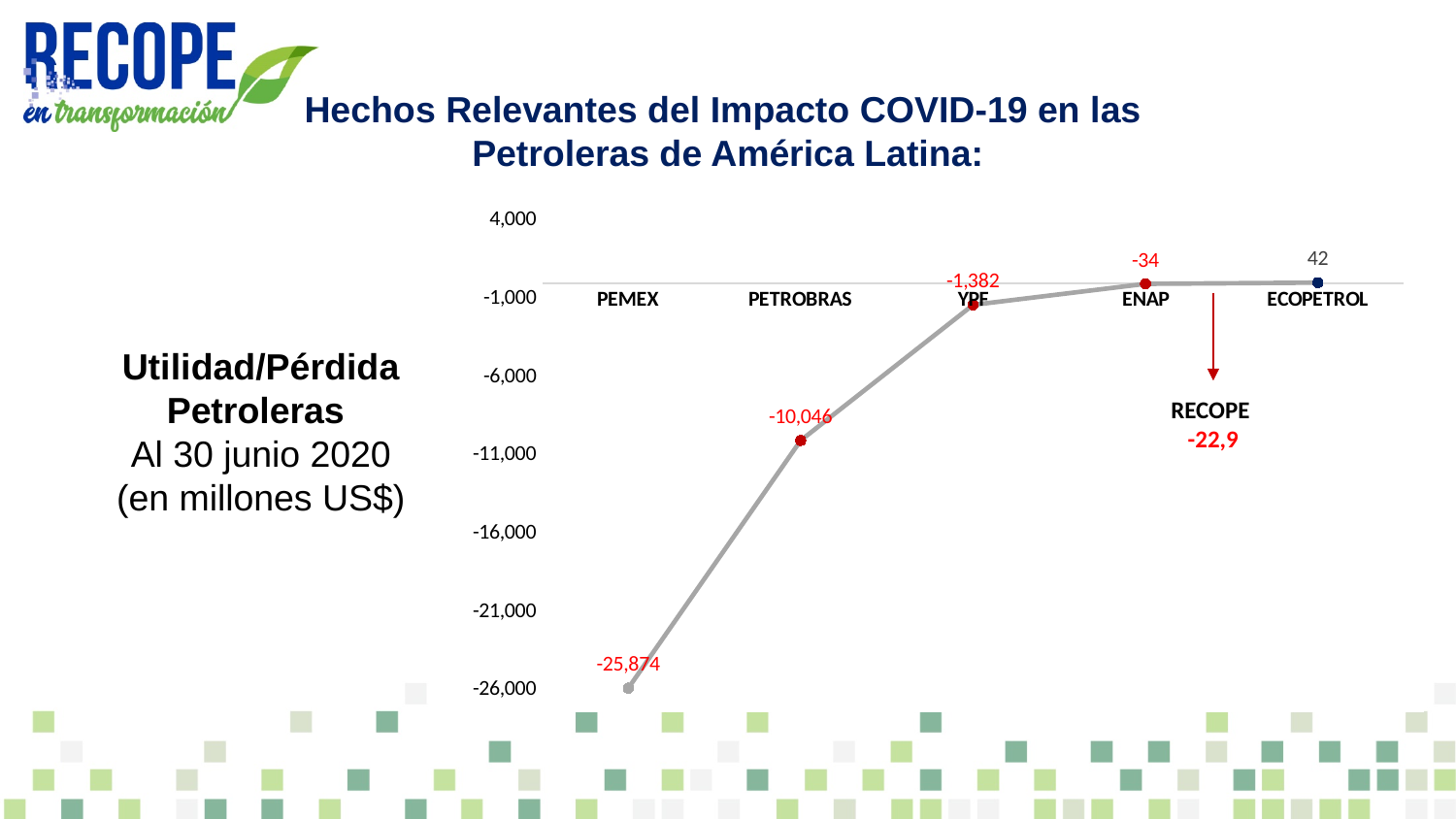
How many companies are plotted on the chart? 5 What is the value for PETROBRAS? -10,046 What kind of chart is shown on the slide? line chart Which company has the highest value? ECOPETROL What is the value for ECOPETROL? 42 What is the value for PEMEX? -25,874 What is the value for ENAP? -34 Which company has the lowest value? PEMEX What is the value for YPF? -1,382 Do the values rise or fall from PEMEX to ECOPETROL along the x axis? rise Which is larger, the value for YPF or the value for PETROBRAS? YPF What is the difference between the values for PETROBRAS and PEMEX? 15,828